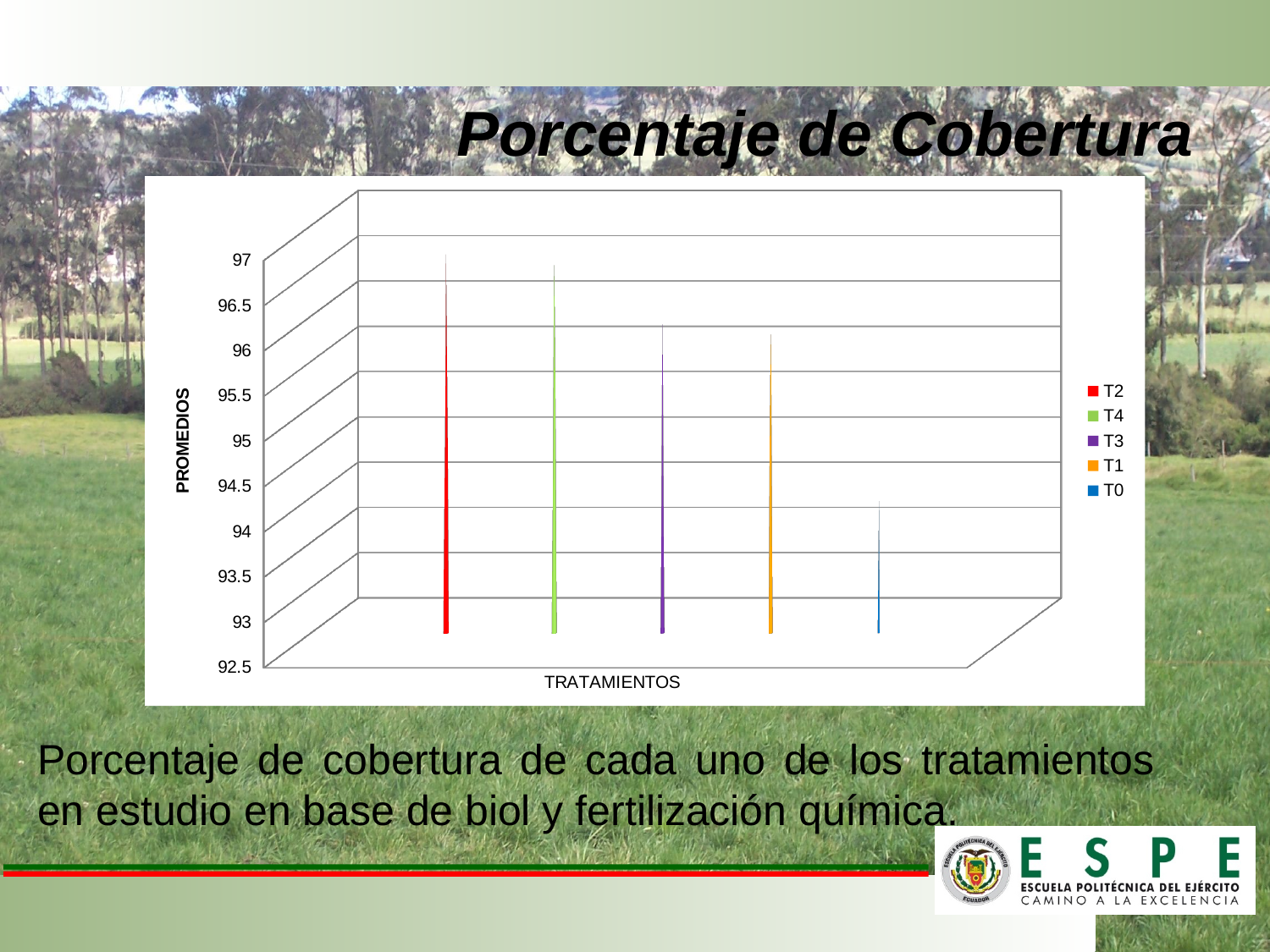
What is the title of the vertical axis? PROMEDIOS Is the value for T0 greater or less than 96? less Is the value for T1 greater or less than 94? greater What is the title of the horizontal axis? TRATAMIENTOS Is the value for T4 greater or less than 95? greater How many bars are plotted in the chart? 5 Which is larger, the value for T4 or the value for T0? T4 Which is larger, the value for T3 or the value for T0? T3 What kind of chart is shown on the slide? bar chart Which treatment has the lowest value? T0 How many series does the legend list? 5